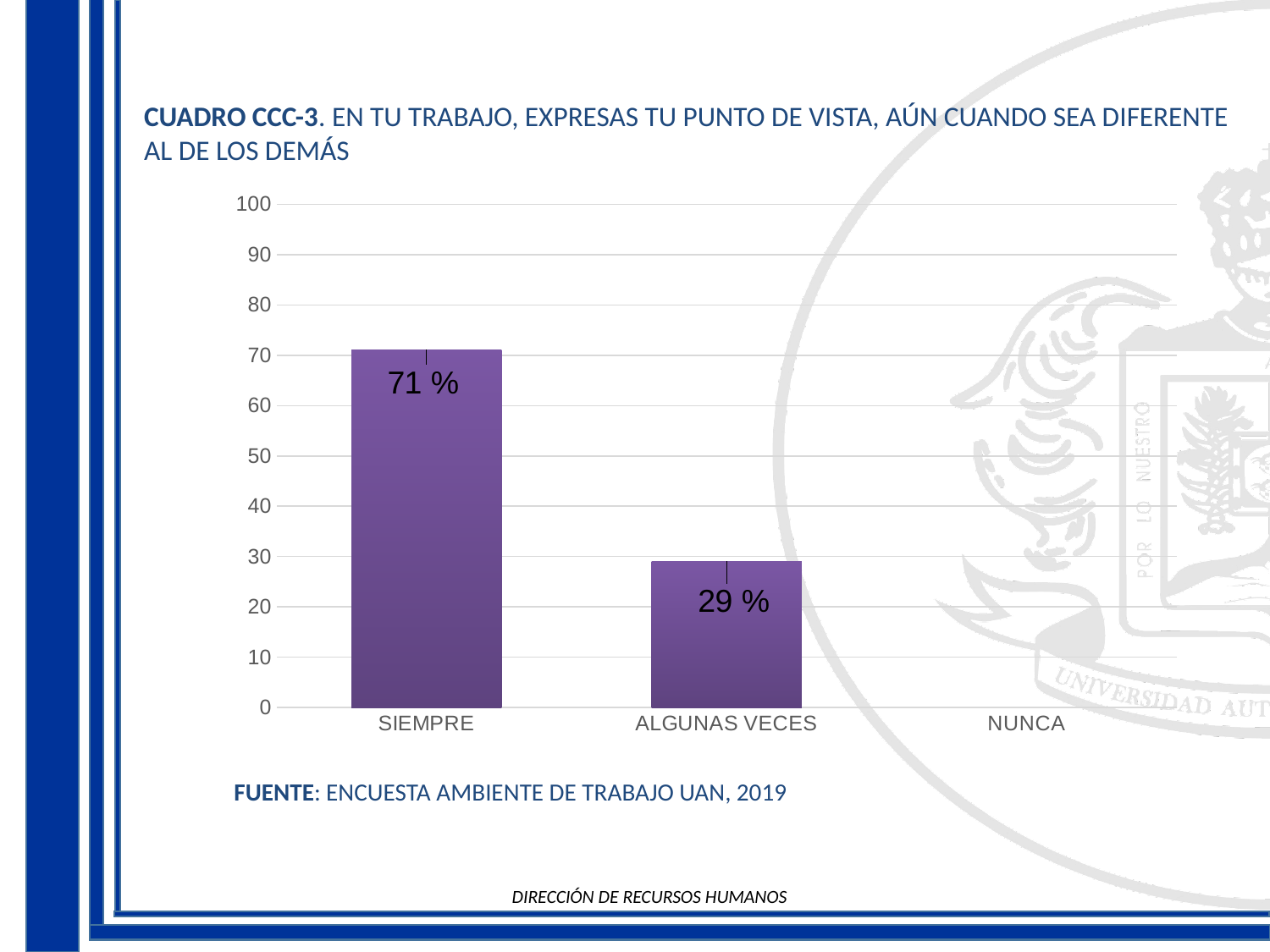
Is the value for SIEMPRE greater or less than 50? greater How many categories are shown on the x axis? 3 Which is larger, the value for SIEMPRE or the value for ALGUNAS VECES? SIEMPRE Do the values rise or fall from left to right along the x axis? fall What kind of chart is shown on the slide? bar chart Which category has the highest value? SIEMPRE What is the value for SIEMPRE? 71 % Is the value for ALGUNAS VECES greater or less than 40? less What is the difference between the values for SIEMPRE and ALGUNAS VECES? 42 % What is the source cited below the chart? ENCUESTA AMBIENTE DE TRABAJO UAN, 2019 What is the value for ALGUNAS VECES? 29 %